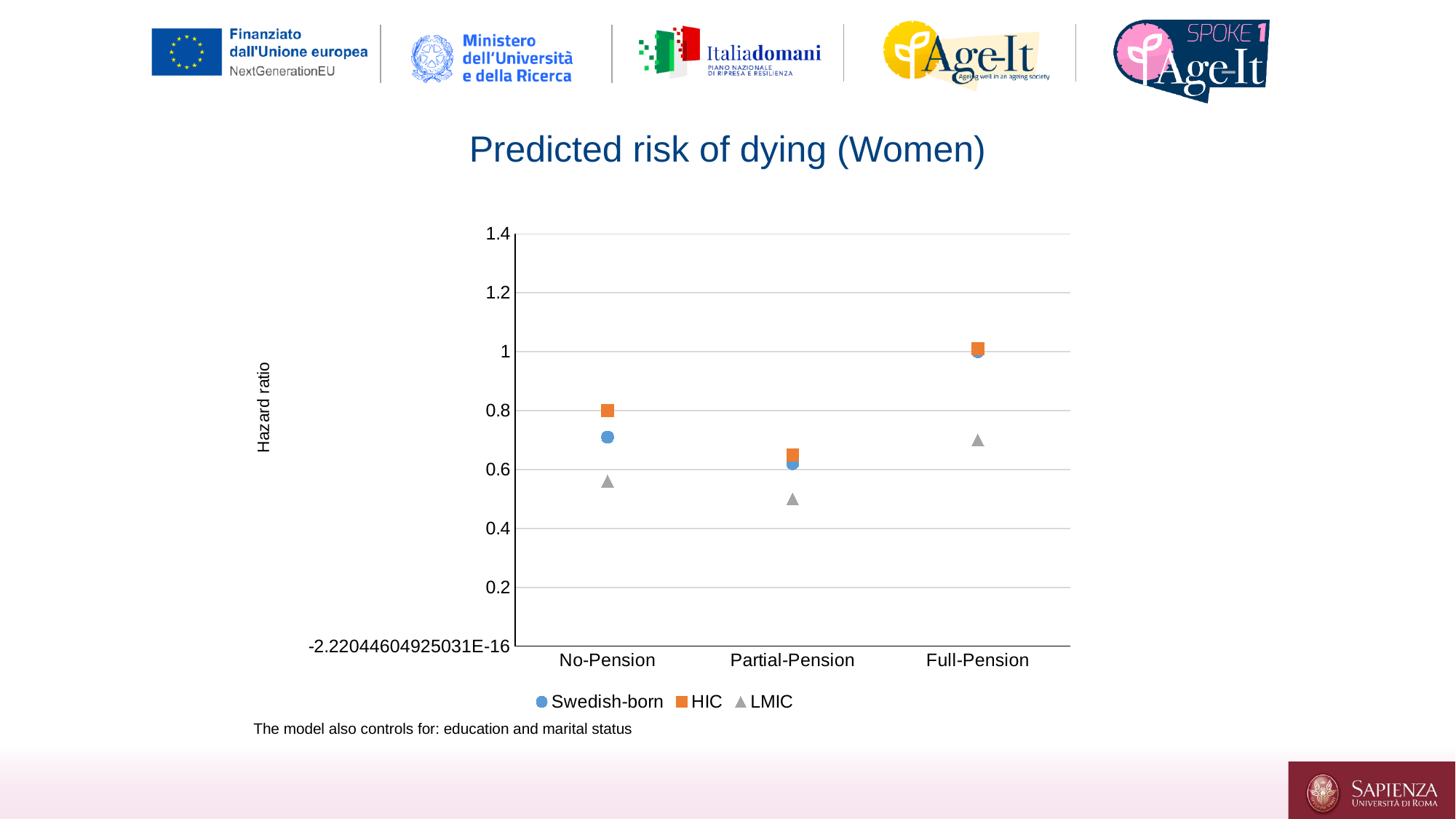
How many series does the legend list? 3 What kind of chart is shown on the slide? Scatter chart Is the Swedish-born value for No-Pension greater or less than 0.8? less What is the label on the vertical axis of the chart? Hazard ratio For Swedish-born, which is larger: the Full-Pension value or the Partial-Pension value? Full-Pension How many pension categories are shown on the x axis? 3 Is the HIC value for Full-Pension greater or less than 0.8? greater Is the LMIC value for Partial-Pension greater or less than 0.6? less For No-Pension, which is larger: the HIC value or the LMIC value? HIC For which pension category is the LMIC value lowest? Partial-Pension For which pension category is the LMIC value highest? Full-Pension Does the LMIC value rise or fall from Partial-Pension to Full-Pension? rise